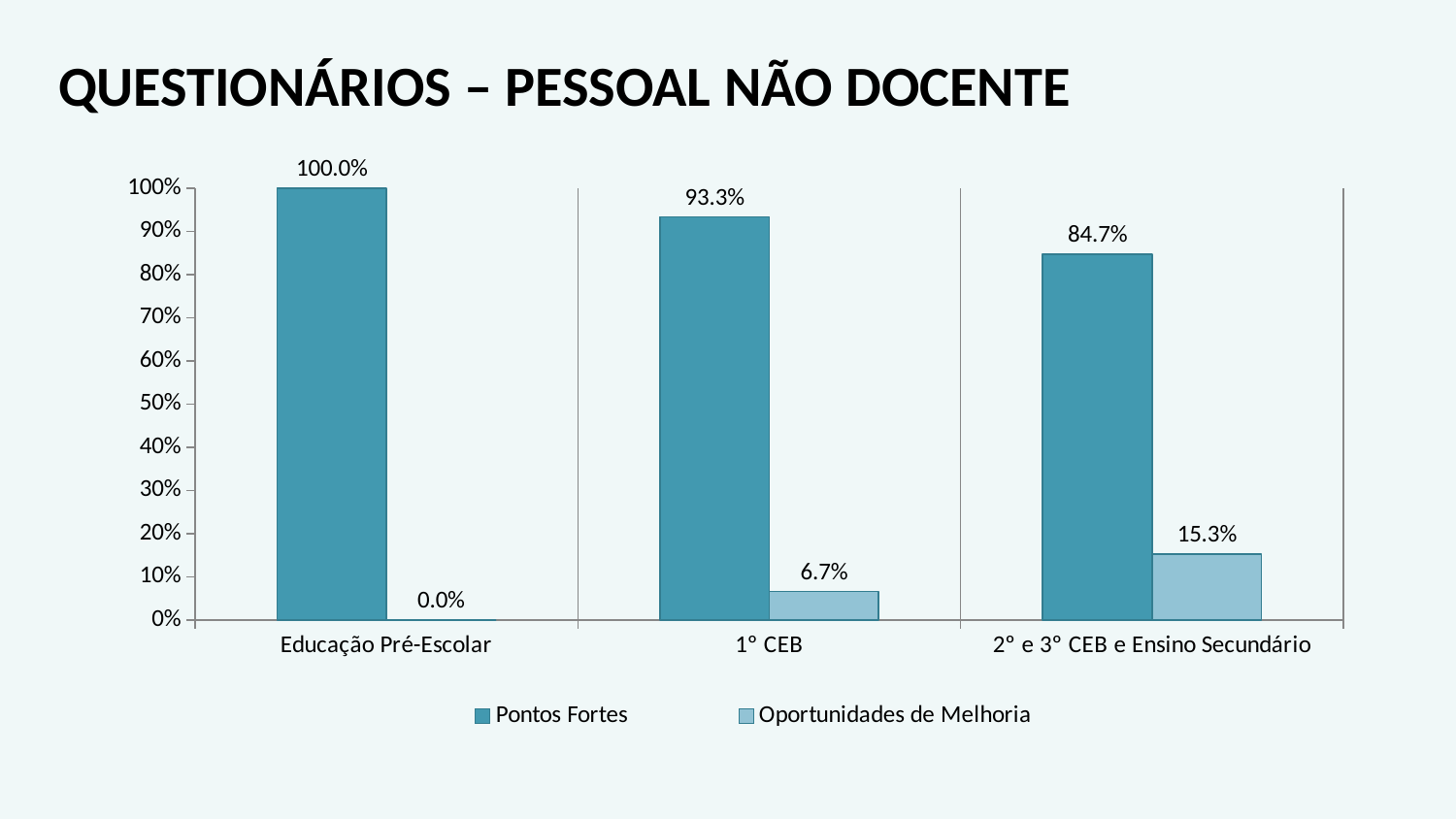
What is the value of Pontos Fortes for 2° e 3° CEB e Ensino Secundário? 84.7% How many series does the legend list? 2 What kind of chart is shown on the slide? Bar chart What is the value of Pontos Fortes for Educação Pré-Escolar? 100.0% What is the value of Oportunidades de Melhoria for Educação Pré-Escolar? 0.0% Which category has the highest Pontos Fortes value? Educação Pré-Escolar Which category has the lowest Oportunidades de Melhoria value? Educação Pré-Escolar What is the difference between the Pontos Fortes values for 1° CEB and 2° e 3° CEB e Ensino Secundário? 8.6% How many categories are shown on the x axis? 3 Which is larger: Oportunidades de Melhoria for 1° CEB or for 2° e 3° CEB e Ensino Secundário? 2° e 3° CEB e Ensino Secundário What is the value of Oportunidades de Melhoria for 1° CEB? 6.7% Do the Pontos Fortes values rise or fall from left to right along the x axis? Fall